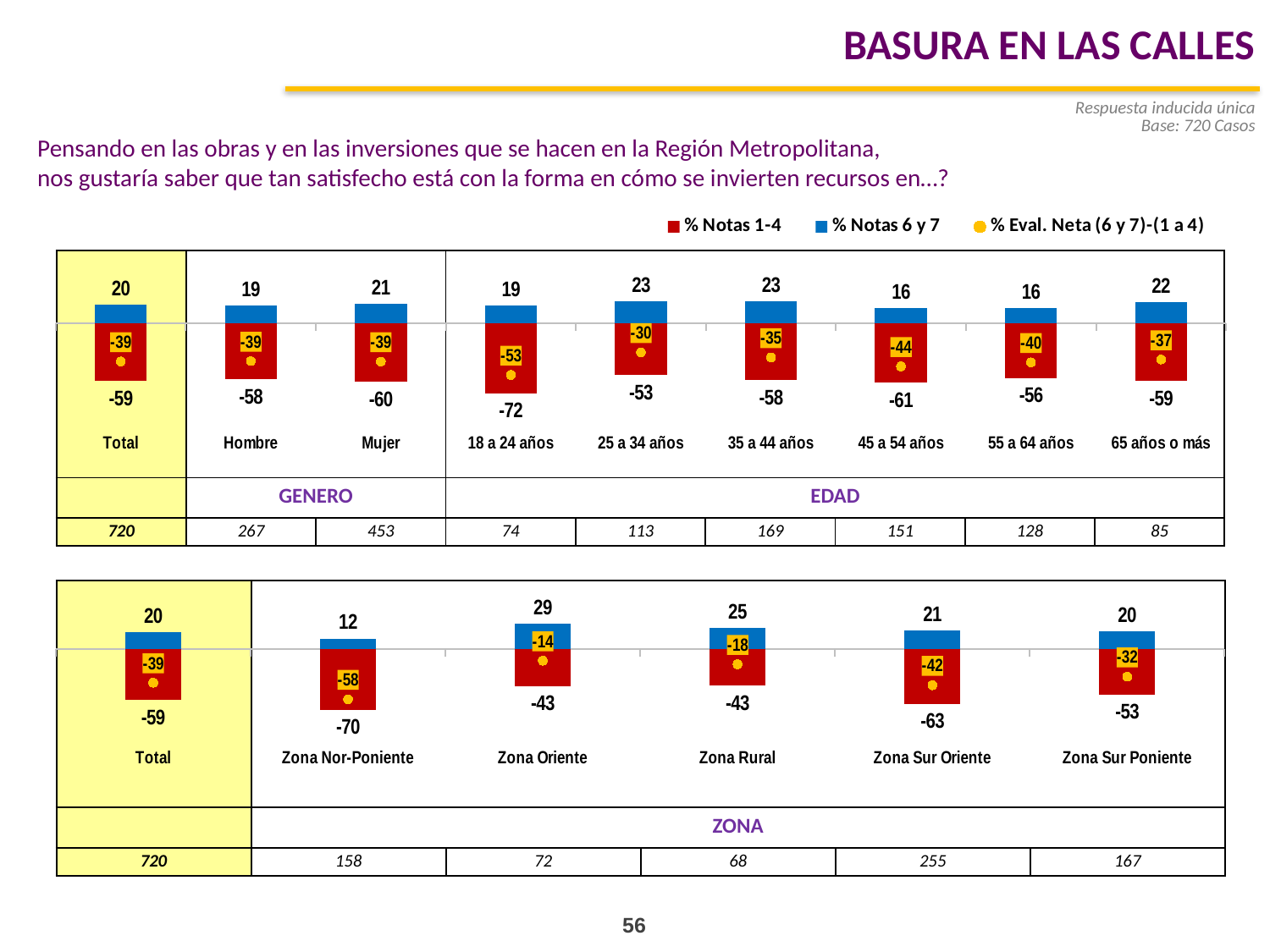
In the bottom chart, which zone has the lowest % Notas 6 y 7 value? Zona Nor-Poniente In the top chart, what is the % Notas 6 y 7 value for 25 a 34 años? 23 In the bottom chart, what is the difference between the % Notas 6 y 7 values for Zona Oriente and Zona Nor-Poniente? 17 How many zone categories (excluding Total) are shown in the bottom chart? 5 In the top chart, which has the higher % Notas 6 y 7 value, Hombre or Mujer? Mujer In the bottom chart, what is the % Eval. Neta value for Zona Rural? -18 What type of chart is used on this slide? Combination bar and line chart (bars with dot markers for the net evaluation series) In the top chart, which age group has the lowest % Eval. Neta value? 18 a 24 años In the bottom chart, which zone has the highest % Notas 6 y 7 value? Zona Oriente In the top chart, what is the % Notas 1-4 value for 18 a 24 años? -72 In the top chart, what is the % Eval. Neta value for Mujer? -39 How many series does the legend list? 3